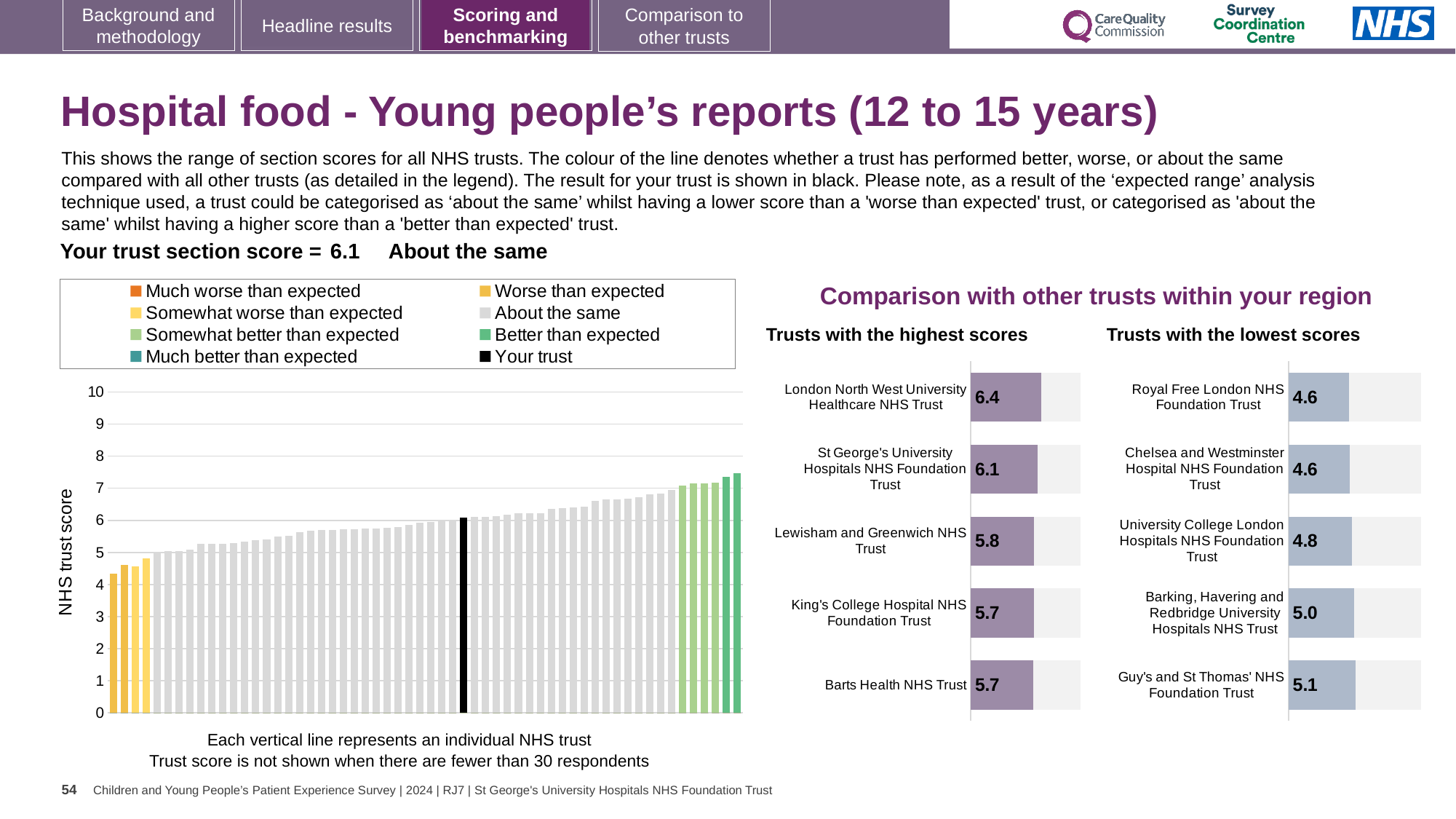
In the 'Trusts with the highest scores' chart, what is the difference between the scores of London North West University Healthcare NHS Trust and Barts Health NHS Trust? 0.7 In the main 'NHS trust score' chart on the left, is the value of the lowest bar greater or less than 5? less In the 'Trusts with the highest scores' chart, what is the score for London North West University Healthcare NHS Trust? 6.4 In the 'Trusts with the lowest scores' chart, what is the score for University College London Hospitals NHS Foundation Trust? 4.8 In the 'Trusts with the lowest scores' chart, which trust has the highest score shown? Guy's and St Thomas' NHS Foundation Trust In the 'Trusts with the lowest scores' chart, what is the score for Guy's and St Thomas' NHS Foundation Trust? 5.1 How many trusts are listed in the 'Trusts with the highest scores' chart? 5 In the 'Trusts with the lowest scores' chart, what is the difference between the scores of Guy's and St Thomas' NHS Foundation Trust and Royal Free London NHS Foundation Trust? 0.5 In the 'Trusts with the highest scores' chart, which trust has the highest score? London North West University Healthcare NHS Trust What kind of chart is the 'NHS trust score' chart on the left of the slide? Bar chart In the 'Trusts with the highest scores' chart, what is the score for Lewisham and Greenwich NHS Trust? 5.8 Which is larger: the score for St George's University Hospitals NHS Foundation Trust in the highest-scores chart or the score for Barking, Havering and Redbridge University Hospitals NHS Trust in the lowest-scores chart? St George's University Hospitals NHS Foundation Trust